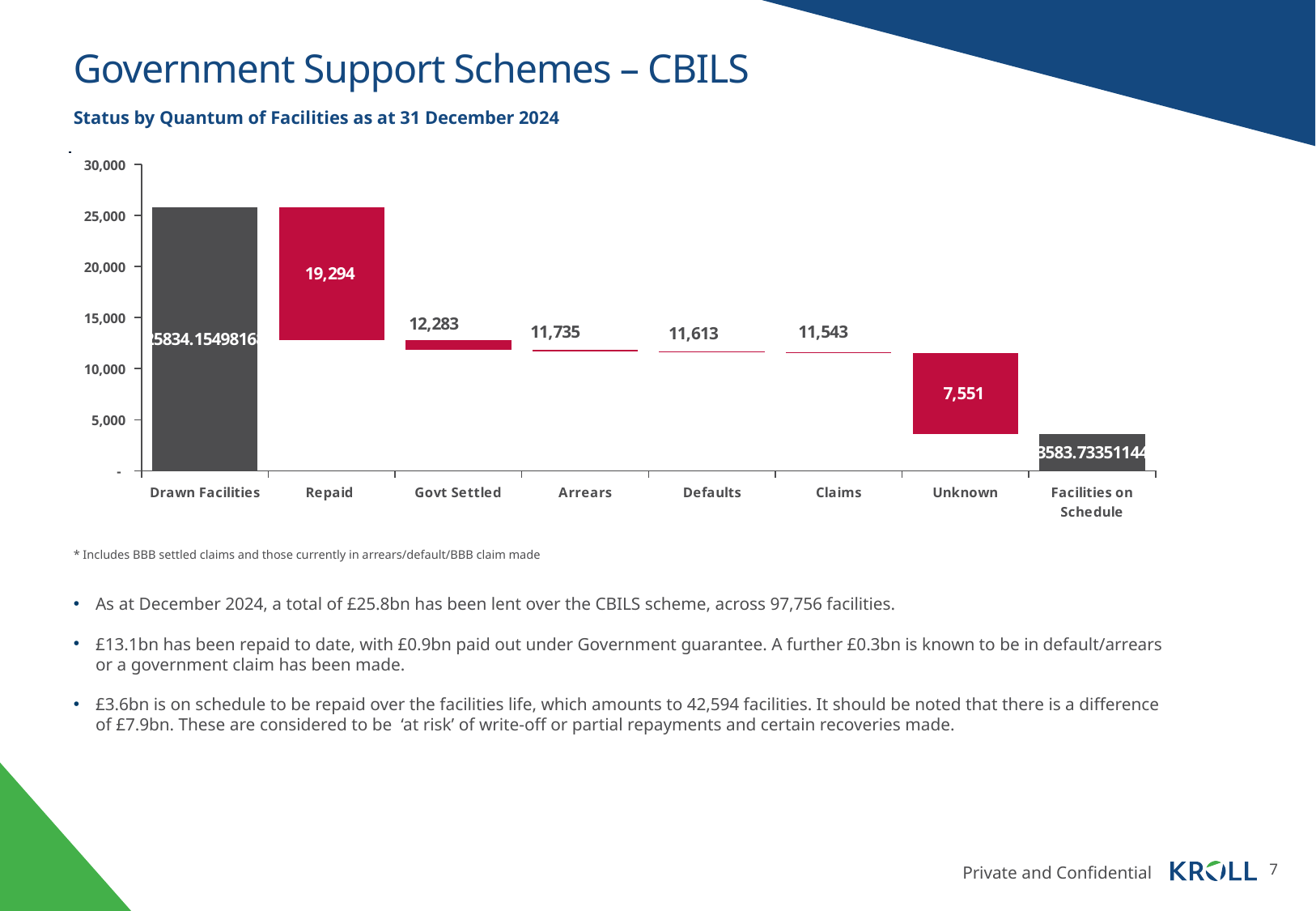
Which category has the tallest bar in the chart? Drawn Facilities What value is labelled on the Unknown bar? 7,551 Which category has the lowest labelled value? Facilities on Schedule Which has the larger labelled value, Defaults or Unknown? Defaults What value is labelled for Claims? 11,543 What value is labelled on the Repaid bar? 19,294 What value is labelled for Govt Settled? 12,283 What is the difference between the labelled values for Repaid and Govt Settled? 7,011 What value is labelled for Arrears? 11,735 What is the title of the chart? Status by Quantum of Facilities as at 31 December 2024 How many categories are shown on the x axis? 8 Is the value for Drawn Facilities greater or less than 25,000? greater